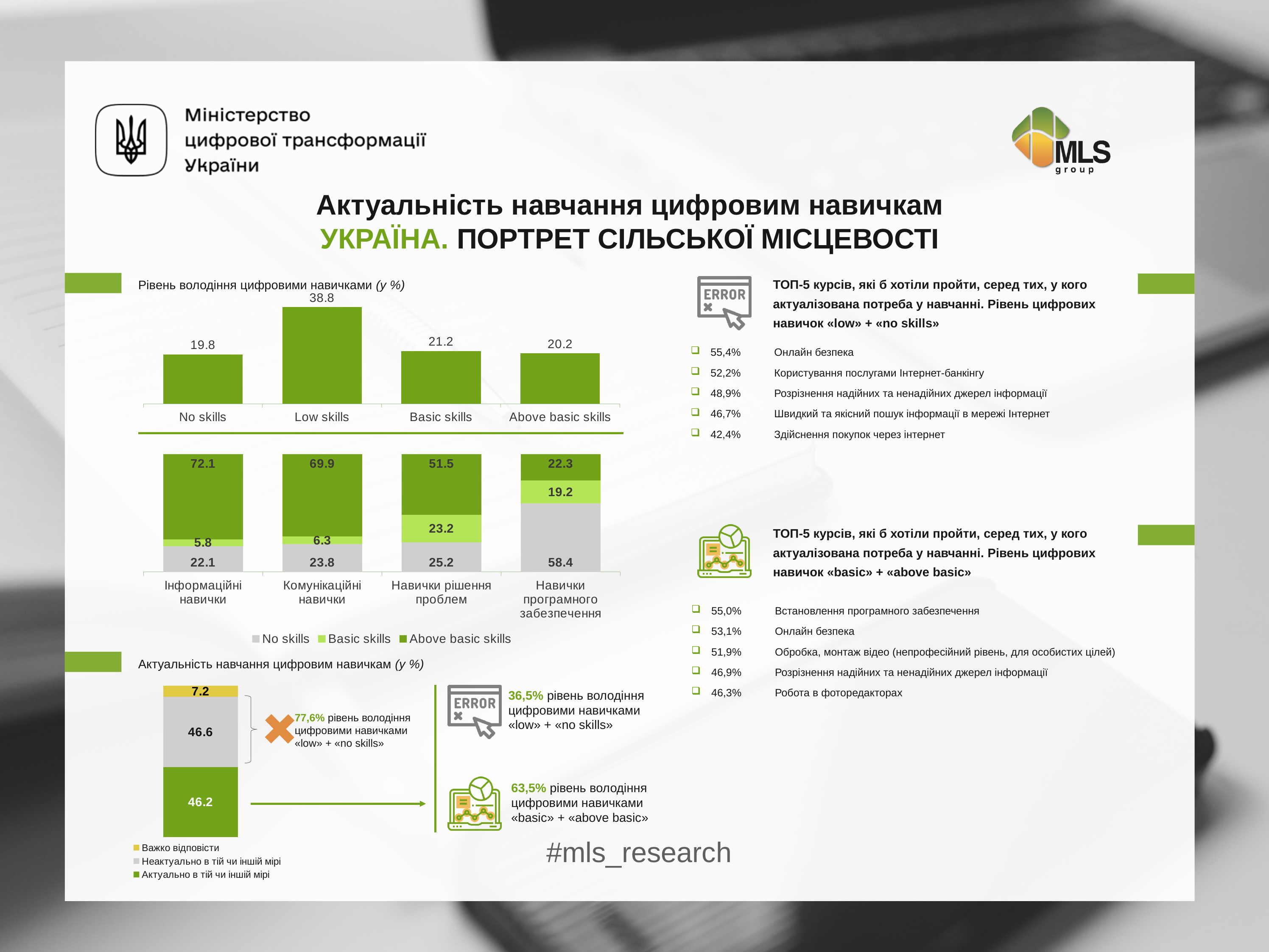
In the top bar chart 'Рівень володіння цифровими навичками (у %)', how many categories are shown? 4 In the top bar chart 'Рівень володіння цифровими навичками (у %)', which category has the highest value? Low skills In the chart 'Актуальність навчання цифровим навичкам (у %)' at the bottom left, what is the value for 'Актуально в тій чи іншій мірі'? 46.2 What kind of chart is 'Рівень володіння цифровими навичками (у %)' at the top left? bar chart In the stacked bar chart in the middle left, what is the 'Above basic skills' value for Інформаційні навички? 72.1 In the stacked bar chart in the middle left, how many series does the legend list? 3 In the stacked bar chart in the middle left, what is the total of the stacked bar for Комунікаційні навички? 100 In the top bar chart 'Рівень володіння цифровими навичками (у %)', what is the value for Low skills? 38.8 In the stacked bar chart in the middle left, which is larger: the 'Basic skills' value for Навички рішення проблем or for Комунікаційні навички? Навички рішення проблем In the top bar chart 'Рівень володіння цифровими навичками (у %)', which category has the lowest value? No skills In the top bar chart 'Рівень володіння цифровими навичками (у %)', what is the difference between Low skills and No skills? 19.0 In the stacked bar chart in the middle left, what is the 'No skills' value for Навички програмного забезпечення? 58.4